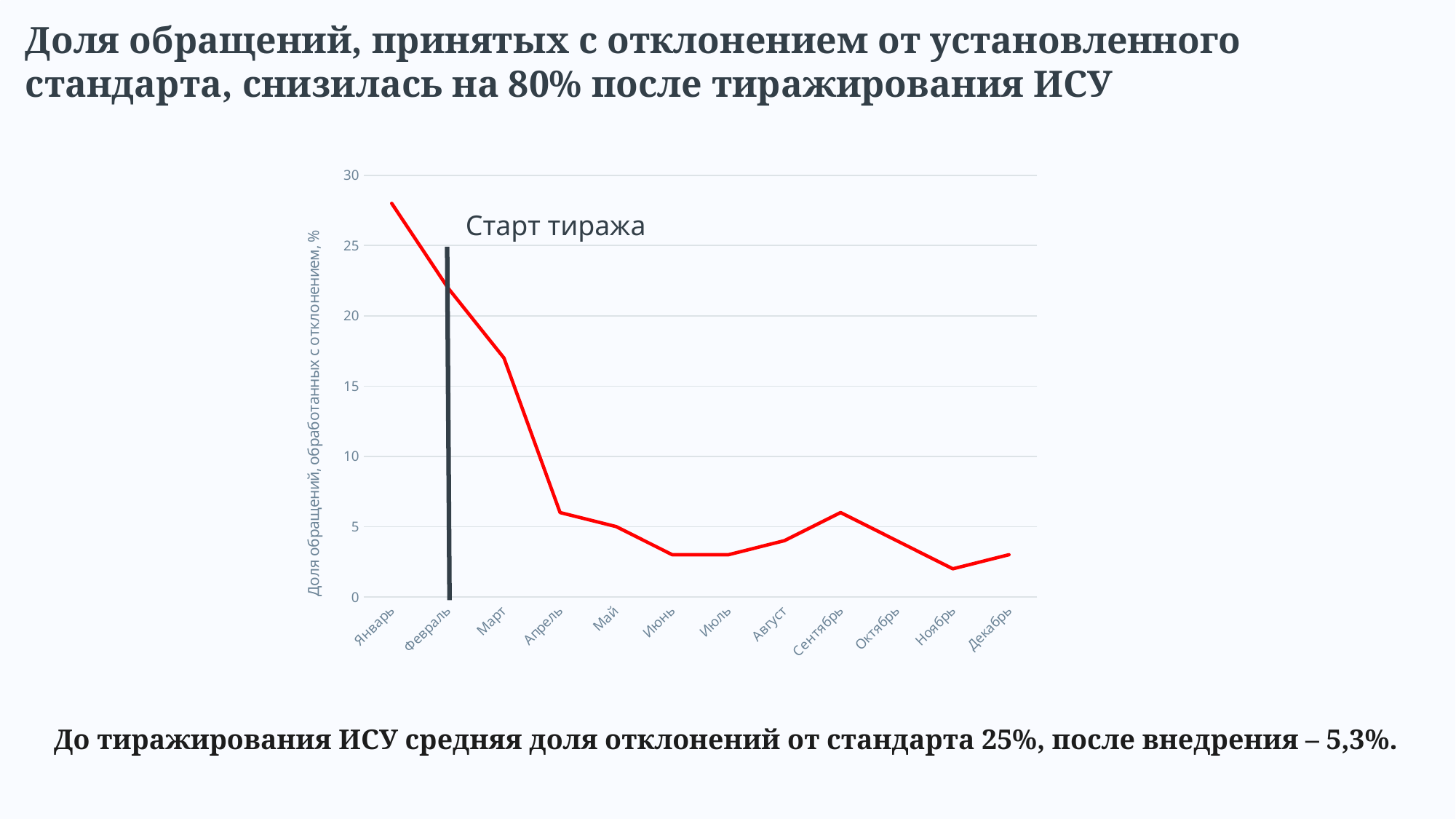
Which is larger, the value for Март or the value for Апрель? Март What does the vertical dark line on the chart mark? Старт тиража Is the value for Январь greater or less than 25? greater How many months are plotted along the x axis? 12 What colour is the plotted line? red Is the value for Апрель greater or less than 10? less Which month has the highest share of deviations? Январь Is the value for Март greater or less than 10? greater Do the values generally rise or fall from Январь to Декабрь? fall What kind of chart is shown on the slide? line chart